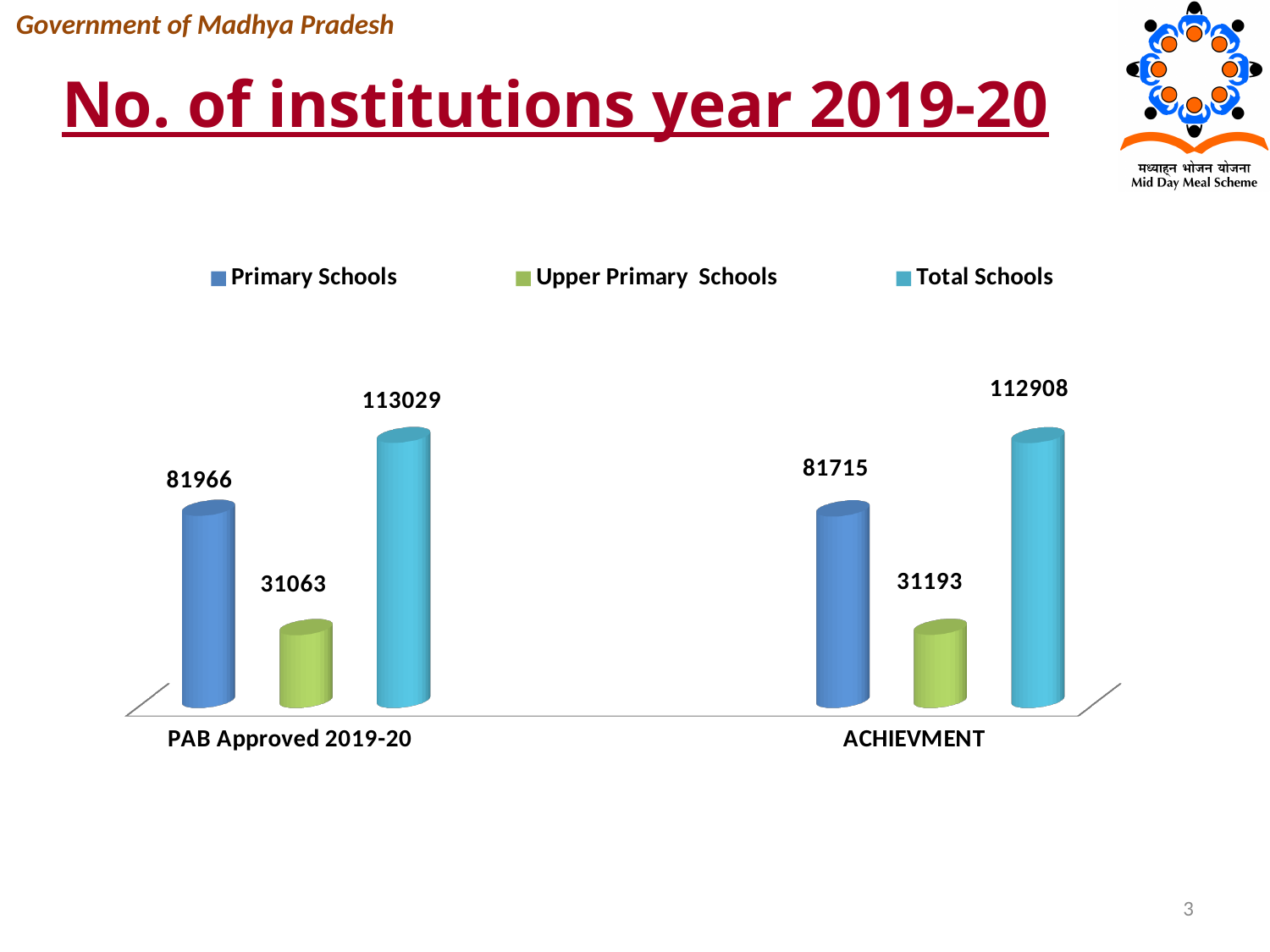
Is the Upper Primary Schools value larger for PAB Approved 2019-20 or for ACHIEVMENT? ACHIEVMENT What is the difference between Primary Schools for PAB Approved 2019-20 and Primary Schools for ACHIEVMENT? 251 What is the value for Primary Schools under PAB Approved 2019-20? 81966 What is the value for Upper Primary Schools under ACHIEVMENT? 31193 How many series does the legend list? 3 What kind of chart is shown on the slide? Bar chart What is the value for Total Schools under ACHIEVMENT? 112908 What is the difference between Total Schools for PAB Approved 2019-20 and Total Schools for ACHIEVMENT? 121 Which series has the lowest value under PAB Approved 2019-20? Upper Primary Schools Which series has the highest value under ACHIEVMENT? Total Schools What is the value for Total Schools under PAB Approved 2019-20? 113029 How many categories are shown on the x axis? 2